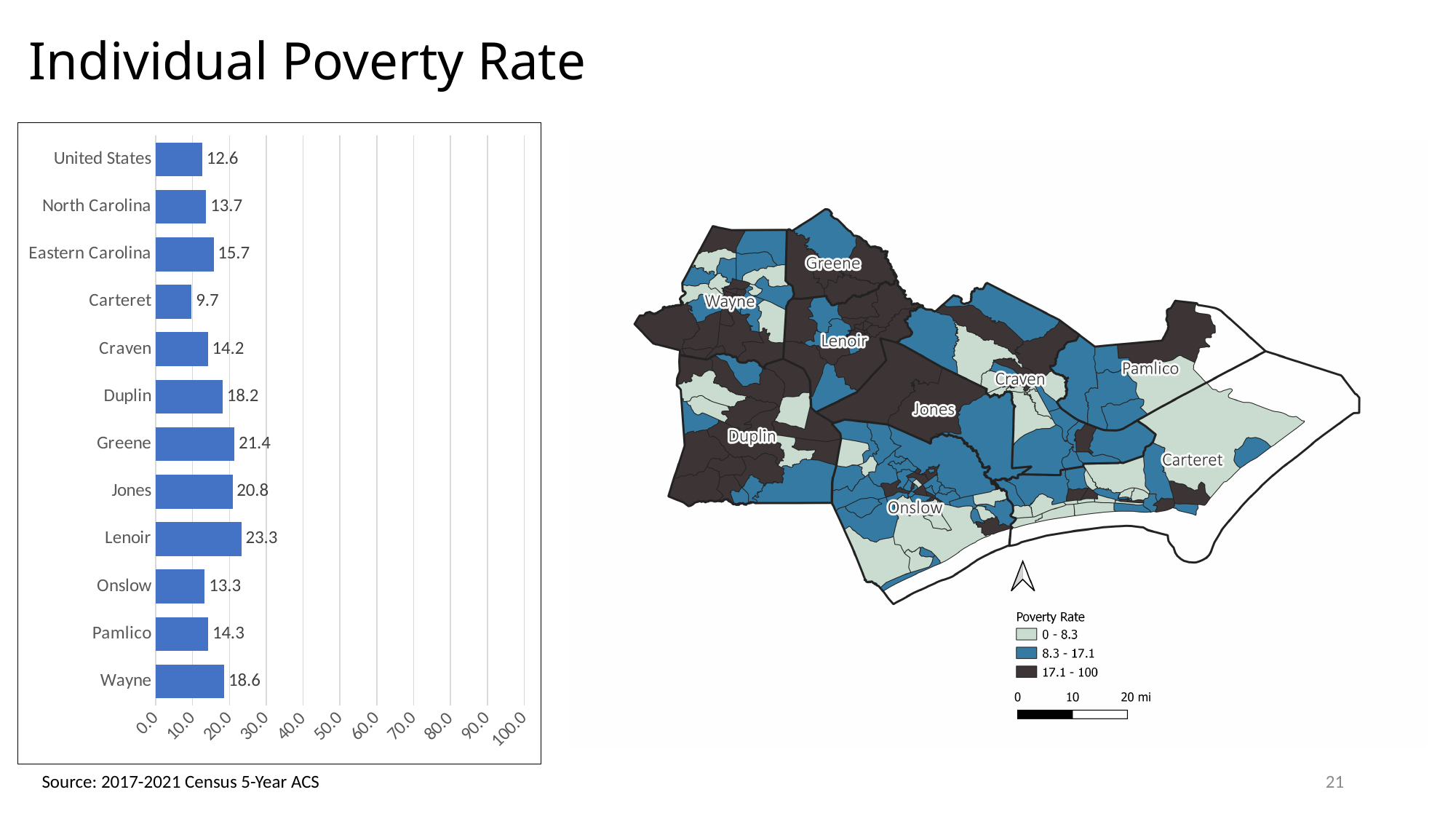
What is the difference between the poverty rates of Wayne and Carteret in the bar chart? 8.9 Which category has the lowest individual poverty rate in the bar chart? Carteret What is the difference between the poverty rates of Greene and Jones in the bar chart? 0.6 Which has a higher poverty rate in the bar chart, Duplin or Onslow? Duplin What kind of chart is used to show the individual poverty rates on the left of the slide? Bar chart What is the maximum value shown on the x axis of the bar chart? 100.0 How many categories are shown in the bar chart? 12 Which category has the highest individual poverty rate in the bar chart? Lenoir What is the individual poverty rate for Lenoir in the bar chart? 23.3 Which has a higher poverty rate in the bar chart, North Carolina or Pamlico? Pamlico What is the individual poverty rate for the United States in the bar chart? 12.6 What is the individual poverty rate for Eastern Carolina in the bar chart? 15.7